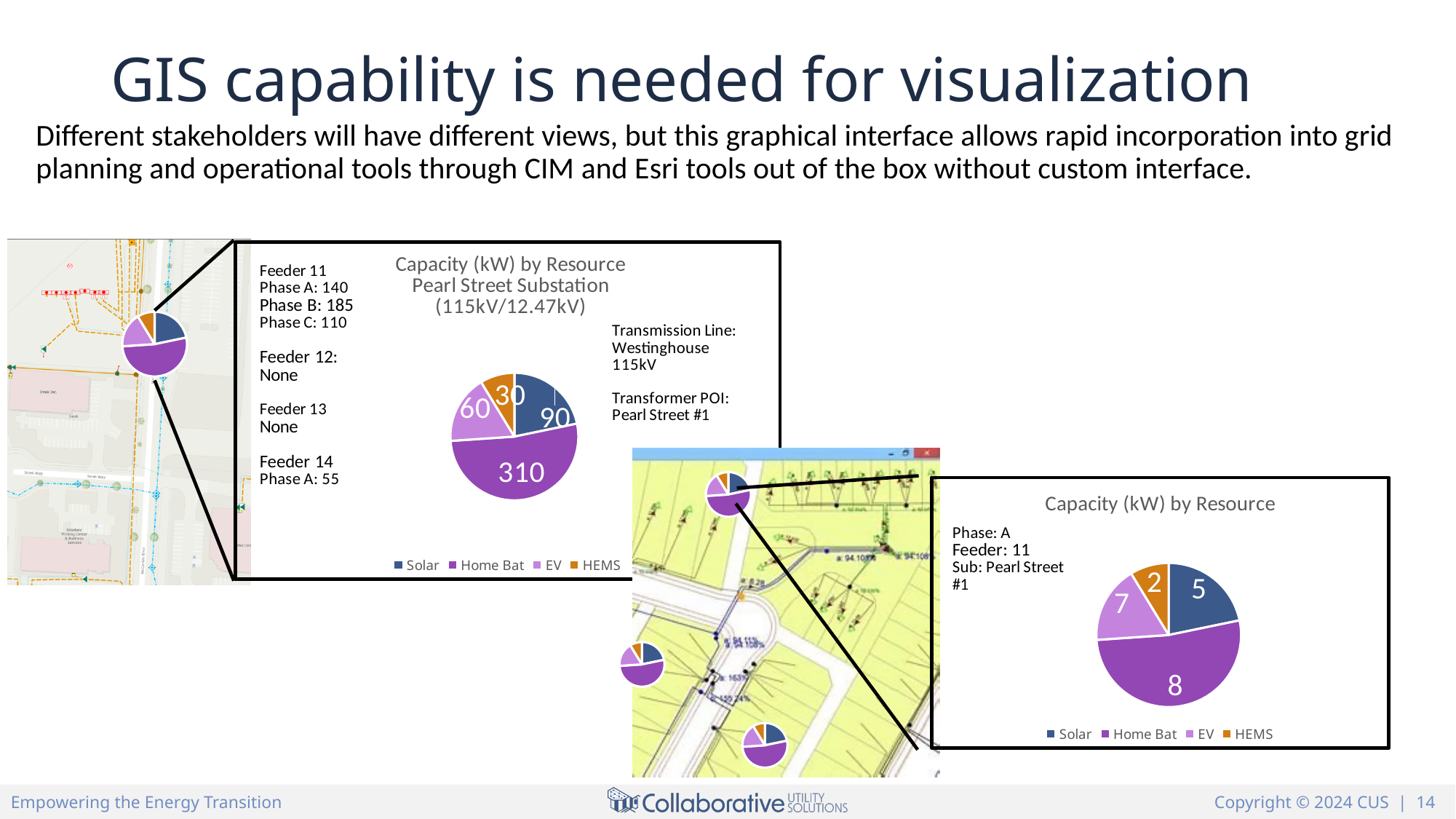
In the Pearl Street Substation pie chart, what is the capacity for Solar? 90 In the Pearl Street Substation pie chart, what is the difference between the Home Bat and Solar values? 220 In the Phase A / Feeder 11 pie chart on the right, what is the total of all slices? 22 In the Pearl Street Substation pie chart, which resource has the smallest capacity? HEMS In the Phase A / Feeder 11 pie chart on the right, which resource has the smallest value? HEMS In the Pearl Street Substation pie chart, what is the capacity for Home Bat? 310 In the Phase A / Feeder 11 pie chart on the right, is the value for Home Bat or Solar larger? Home Bat In the Phase A / Feeder 11 pie chart on the right, what is the value for EV? 7 In the Pearl Street Substation pie chart, what is the total of all four slices? 490 In the Pearl Street Substation pie chart, which resource has the largest capacity? Home Bat In the Pearl Street Substation pie chart, how many series does the legend list? 4 What type of chart is used to show Capacity (kW) by Resource on this slide? Pie chart